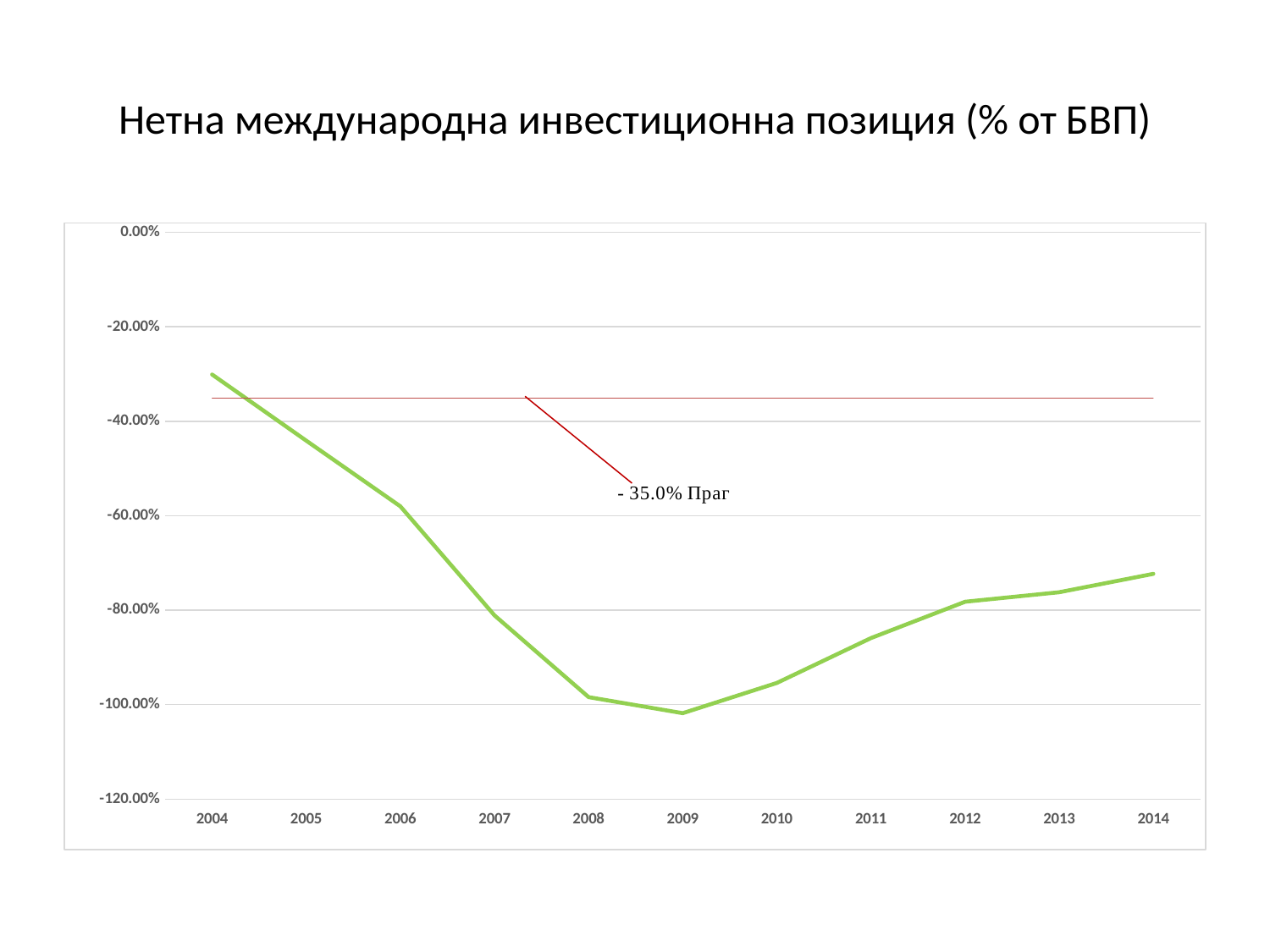
Is the value for 2004 greater or less than -40.00%? greater What kind of chart is shown on the slide? line chart Is the value for 2011 greater or less than -80.00%? less How many years are plotted along the x axis? 11 Is the value for 2009 greater or less than -80.00%? less Which year has the lowest value on the chart? 2009 What threshold level is marked by the red horizontal line? - 35.0% Праг What is the title of the chart? Нетна международна инвестиционна позиция (% от БВП) Which year has the highest value on the chart? 2004 Do the values rise or fall from 2004 to 2009? fall Which year has the larger value, 2004 or 2009? 2004